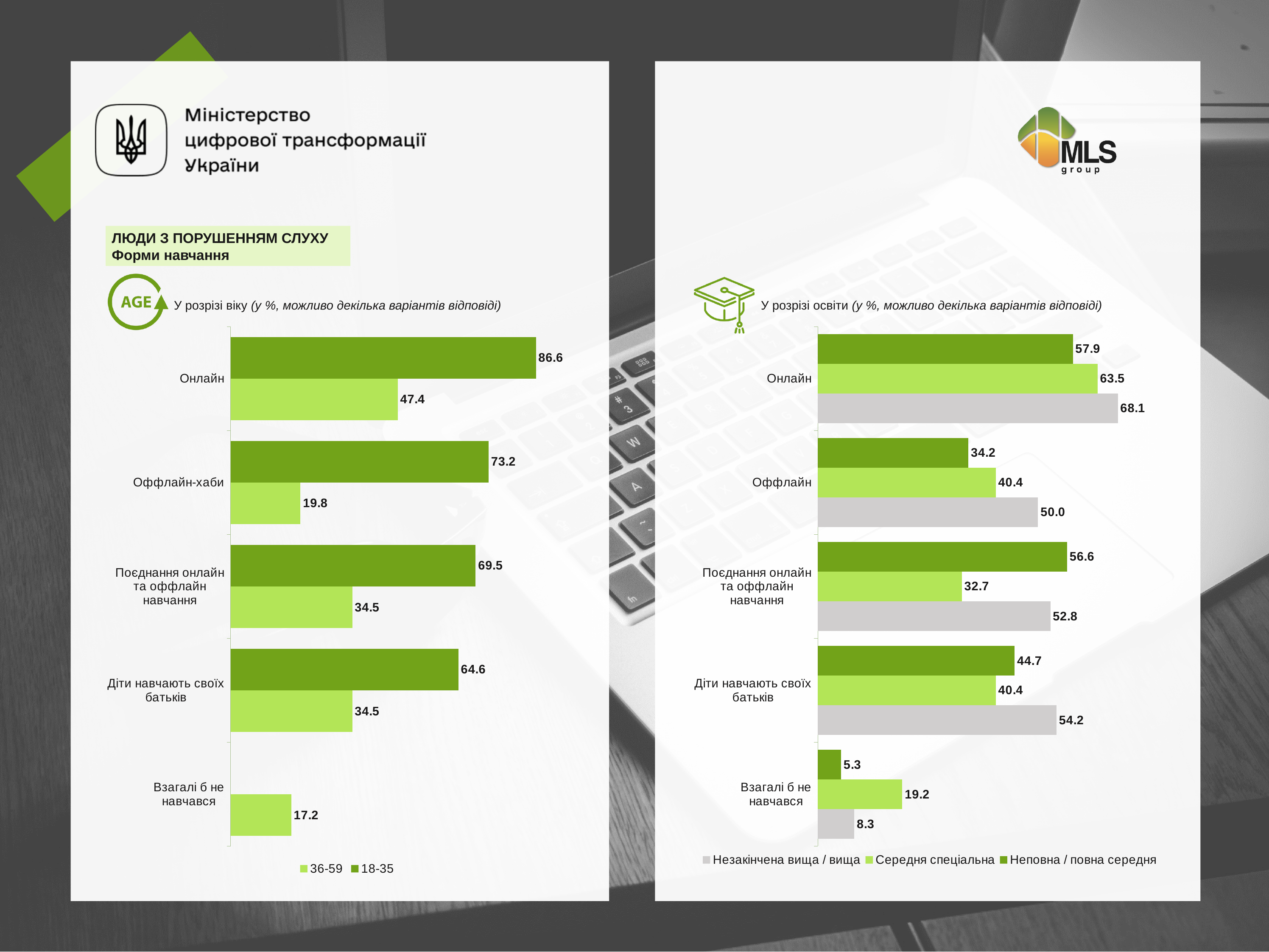
In the education chart (У розрізі освіти), which category has the lowest value in the Неповна / повна середня series? Взагалі б не навчався In the education chart (У розрізі освіти), how many categories are shown? 5 In the education chart (У розрізі освіти), what is the value for Онлайн in the Незакінчена вища / вища series? 68.1 In the age chart (У розрізі віку), what is the difference between the 18-35 and 36-59 values for Онлайн? 39.2 What type of chart is the education chart (У розрізі освіти)? Bar chart In the age chart (У розрізі віку), what is the value for Онлайн in the 18-35 series? 86.6 In the education chart (У розрізі освіти), how many series does the legend list? 3 In the education chart (У розрізі освіти), which is larger for Діти навчають своїх батьків: Незакінчена вища / вища or Середня спеціальна? Незакінчена вища / вища In the age chart (У розрізі віку), how many series does the legend list? 2 In the age chart (У розрізі віку), what is the value for Оффлайн-хаби in the 36-59 series? 19.8 In the age chart (У розрізі віку), what is the value for Взагалі б не навчався in the 36-59 series? 17.2 In the age chart (У розрізі віку), which category has the highest value in the 18-35 series? Онлайн